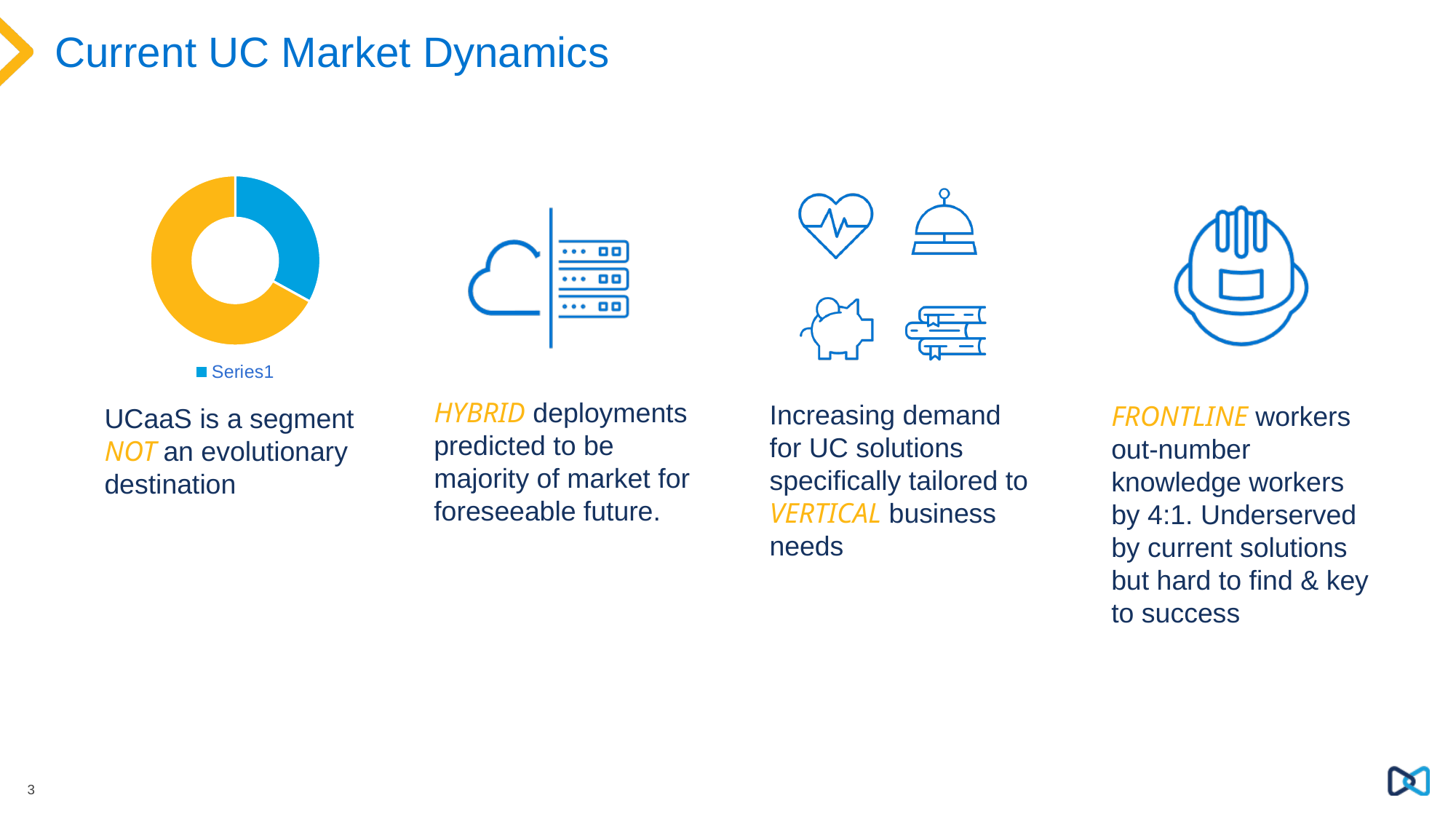
Which slice of the doughnut chart is larger, the yellow one or the blue one? the yellow one What kind of chart is shown on the left of the slide? doughnut chart How many series does the legend of the doughnut chart list? 1 What is the legend entry shown below the doughnut chart? Series1 How many slices does the doughnut chart have? 2 Which colour is used for the smaller slice of the doughnut chart? blue